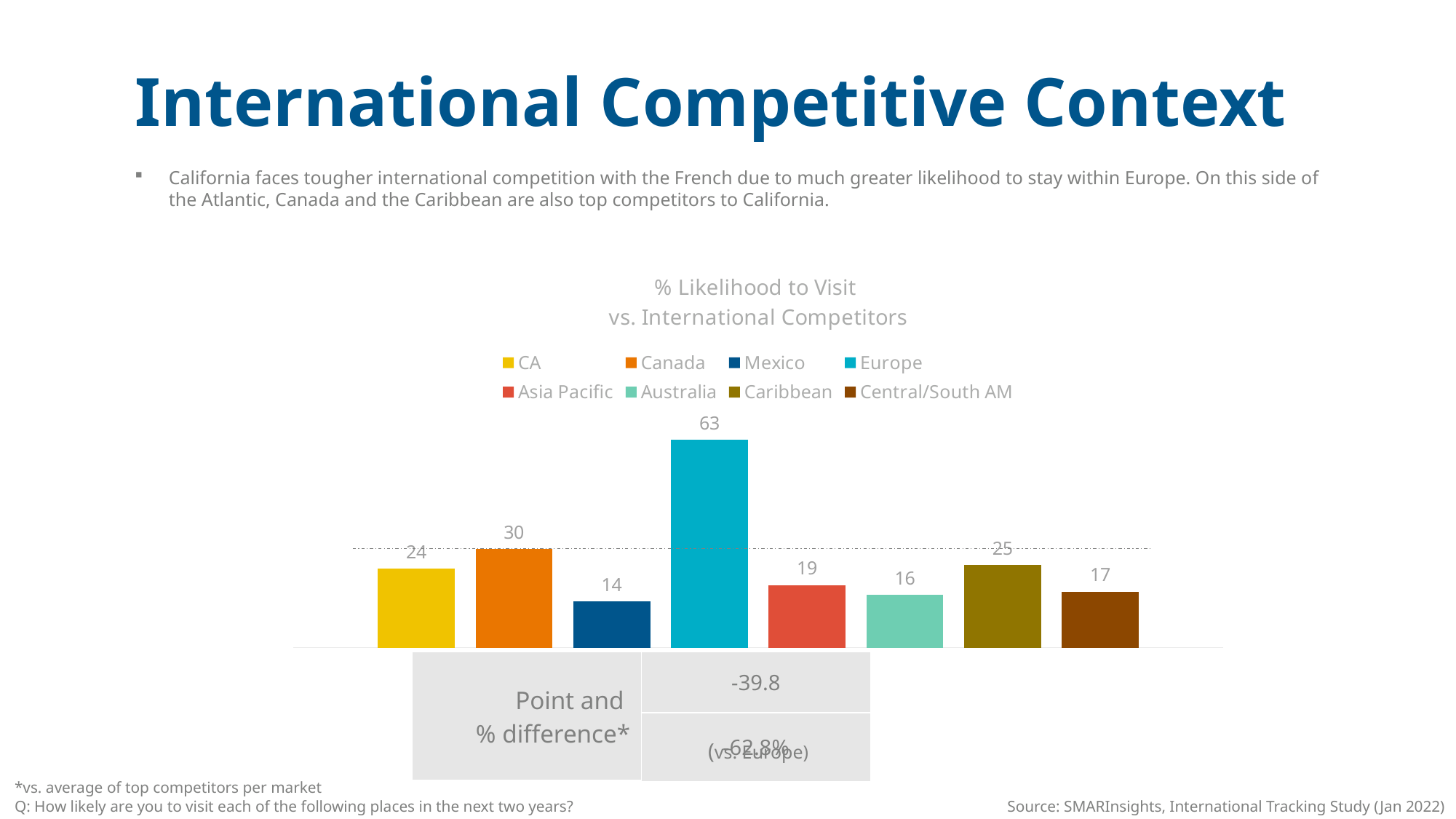
What is the value for Canada in the % Likelihood to Visit chart? 30 How many bars are plotted in the % Likelihood to Visit chart? 8 What is the value for CA in the % Likelihood to Visit chart? 24 Which destination has the lowest value in the % Likelihood to Visit chart? Mexico Which has a larger value in the % Likelihood to Visit chart, Asia Pacific or Australia? Asia Pacific What is the value for Europe in the % Likelihood to Visit chart? 63 What is the difference between the values for Canada and Caribbean in the % Likelihood to Visit chart? 5 What kind of chart is shown on the slide? Bar chart How many entries does the legend of the % Likelihood to Visit chart list? 8 What is the difference between the values for Europe and CA in the % Likelihood to Visit chart? 39 What is the value for Central/South AM in the % Likelihood to Visit chart? 17 Which destination has the highest value in the % Likelihood to Visit chart? Europe